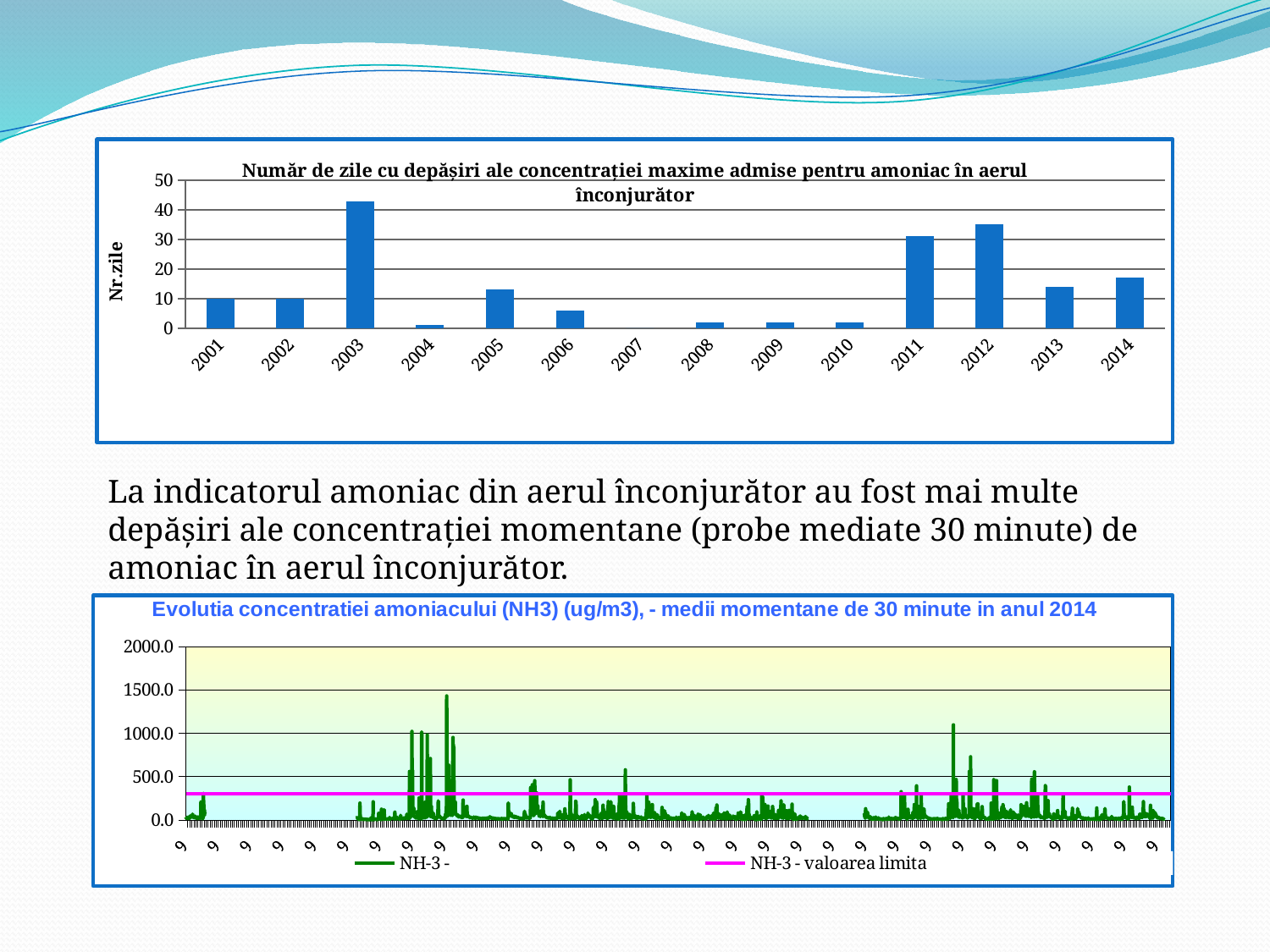
In the top chart, which year has the lowest number of days with exceedances? 2007 What kind of chart is the top chart on the slide? bar chart In the top chart, how many years are shown on the x axis? 14 How many series does the legend of the bottom chart list? 2 In the bottom chart, what is the highest value shown on the y axis? 2000.0 In the top chart, is the value for 2006 greater or less than 10? less In the top chart, is the value for 2012 greater or less than 30? greater In the top chart, which year has the larger value, 2011 or 2013? 2011 In the top chart, which year has the larger value, 2014 or 2005? 2014 In the top chart, is the value for 2003 greater or less than 40? greater What is the y-axis label of the top chart? Nr.zile In the top chart, which year has the highest number of days with exceedances? 2003